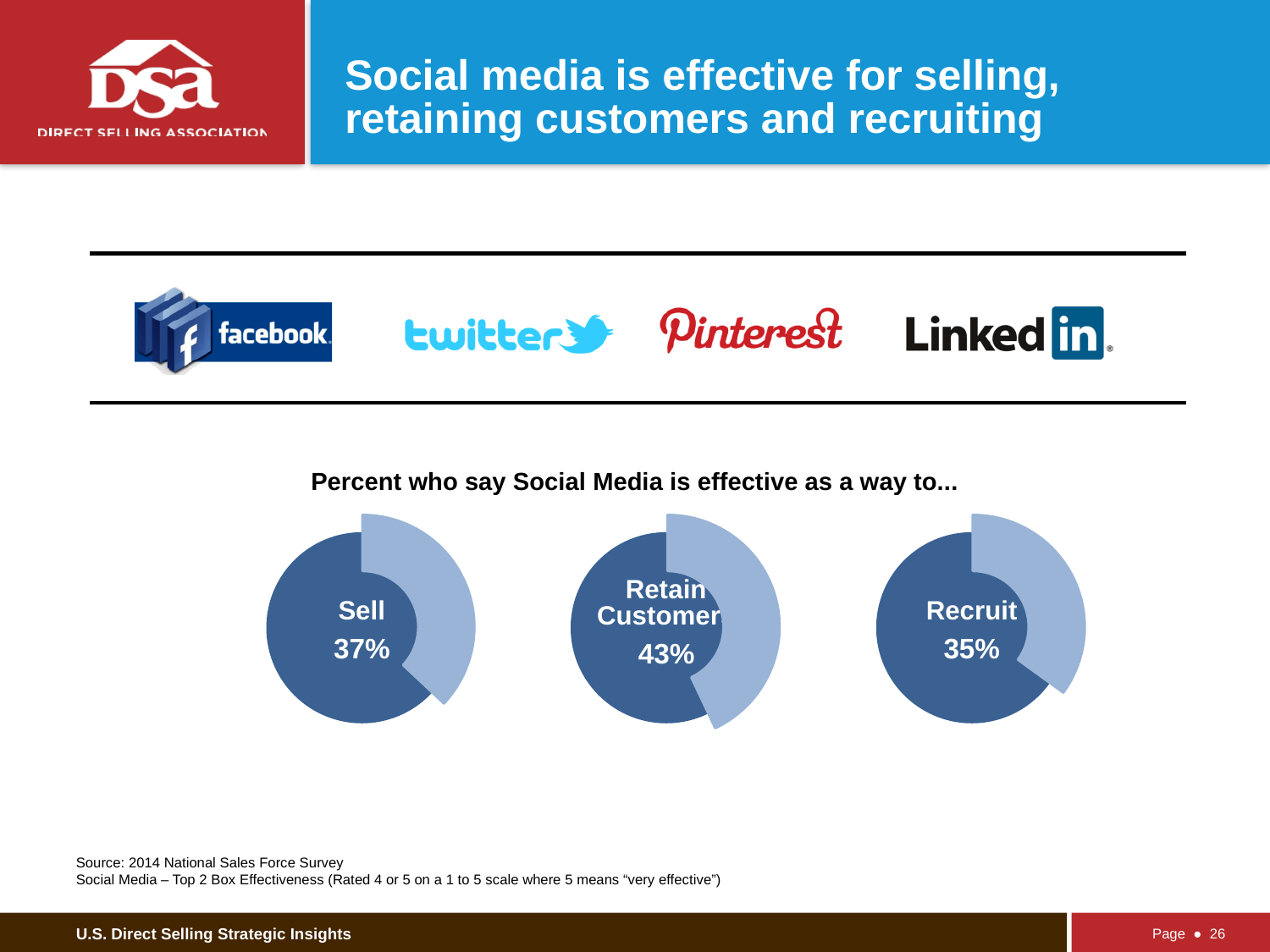
Which is larger, the percentage for Sell or the percentage for Recruit? Sell What percent say social media is effective as a way to retain customers? 43% How many donut charts are shown on the slide? 3 Which of the three uses (Sell, Retain Customer, Recruit) has the lowest percentage? Recruit What percent say social media is effective as a way to sell? 37% Which is larger, the percentage for Retain Customer or the percentage for Recruit? Retain Customer What is the difference in percentage points between Sell and Recruit? 2 What is the difference in percentage points between Retain Customer and Sell? 6 What is the title above the three charts? Percent who say Social Media is effective as a way to... Which of the three uses (Sell, Retain Customer, Recruit) has the highest percentage? Retain Customer What percent say social media is effective as a way to recruit? 35% What kind of chart is used to show the percentages for Sell, Retain Customer and Recruit? Pie (donut) chart